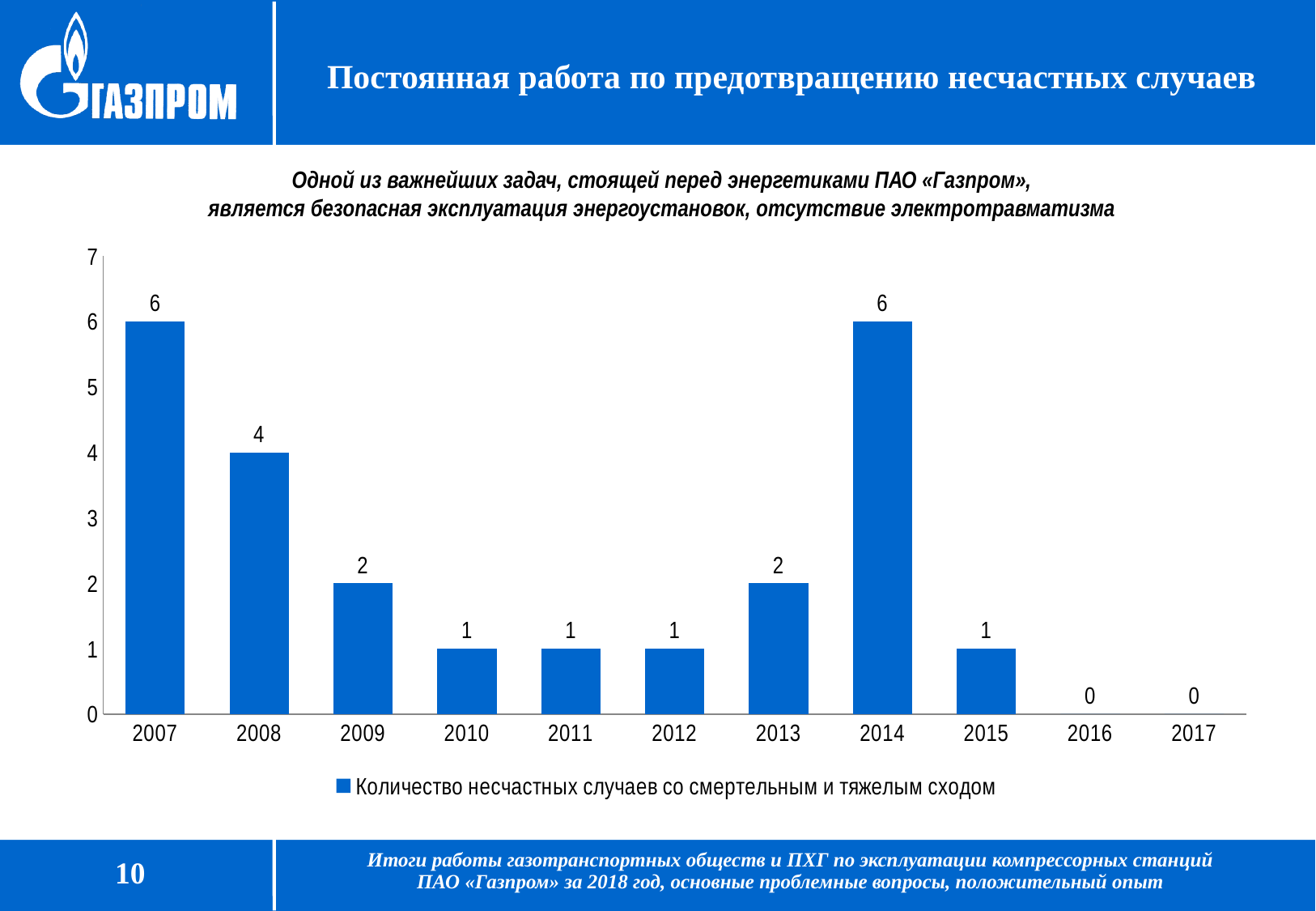
How many years are shown on the x axis? 11 What is the difference between the values for 2007 and 2008? 2 What is the value for 2007? 6 Which is larger, the value for 2009 or the value for 2010? 2009 How many series does the legend list? 1 What is the value for 2008? 4 What is the difference between the values for 2014 and 2015? 5 What is the highest value shown on the chart? 6 What kind of chart is shown on the slide? Bar chart What is the value for 2016? 0 What is the value for 2014? 6 Which is larger, the value for 2013 or the value for 2015? 2013